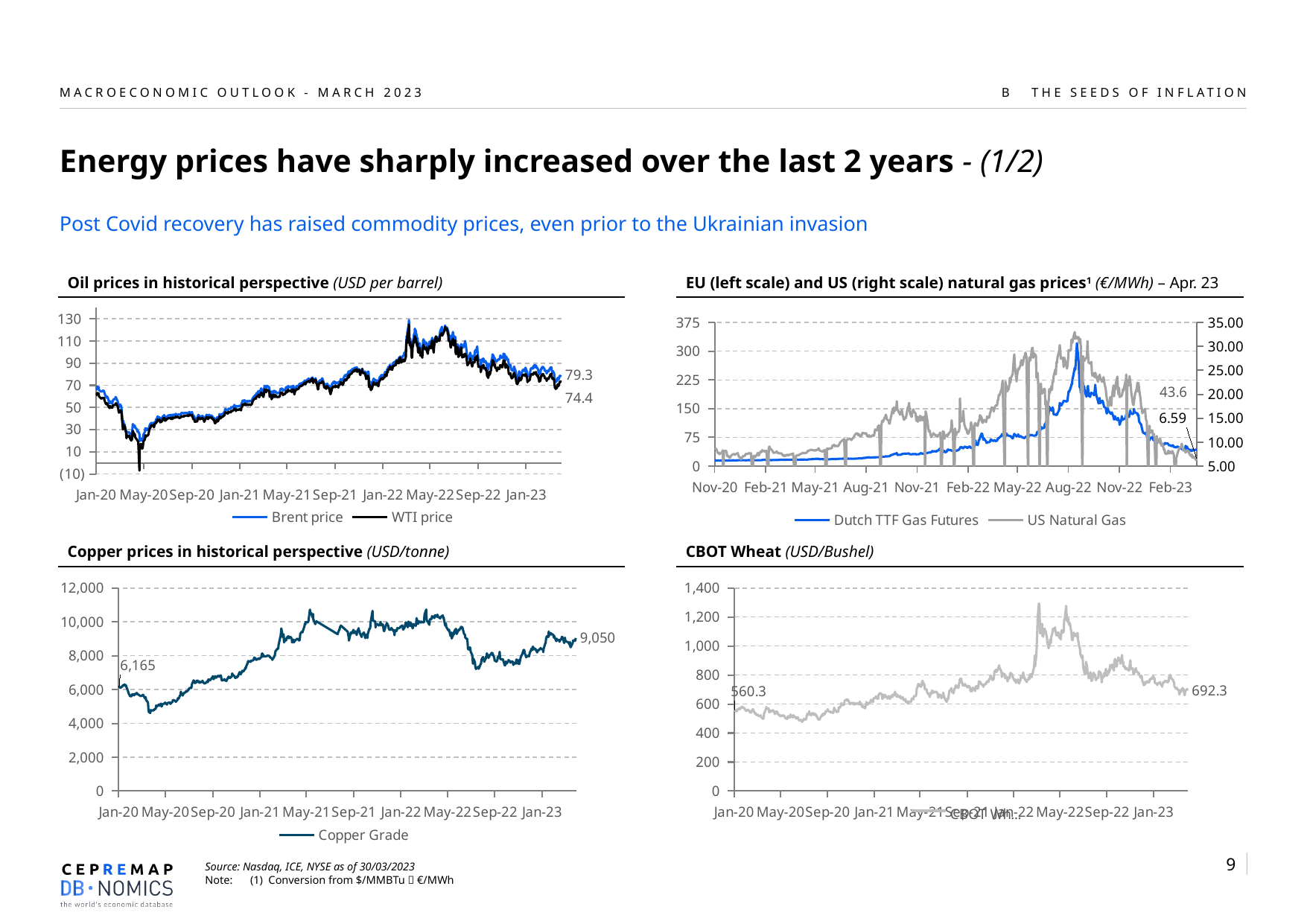
On the 'Oil prices in historical perspective' chart, what is the latest labelled value for the WTI price? 74.4 On the 'Oil prices in historical perspective' chart, what is the latest labelled value for the Brent price? 79.3 On the 'CBOT Wheat' chart, is the peak value greater or less than 1,200? greater On the 'Copper prices in historical perspective' chart, what is the difference between the labelled end value and the labelled start value? 2,885 On the 'Oil prices in historical perspective' chart, what is the difference between the latest labelled Brent price and WTI price? 4.9 On the 'Oil prices in historical perspective' chart, which series has the higher latest labelled value, Brent price or WTI price? Brent price On the 'EU (left scale) and US (right scale) natural gas prices' chart, what is the latest labelled value for US Natural Gas? 6.59 On the 'EU (left scale) and US (right scale) natural gas prices' chart, what is the latest labelled value for Dutch TTF Gas Futures? 43.6 On the 'CBOT Wheat' chart, what is the labelled value at the end of the series? 692.3 How many series does the legend of the 'Oil prices in historical perspective' chart list? 2 What kind of chart is the 'Copper prices in historical perspective' chart? Line chart On the 'Copper prices in historical perspective' chart, what is the labelled value at the start of the series? 6,165